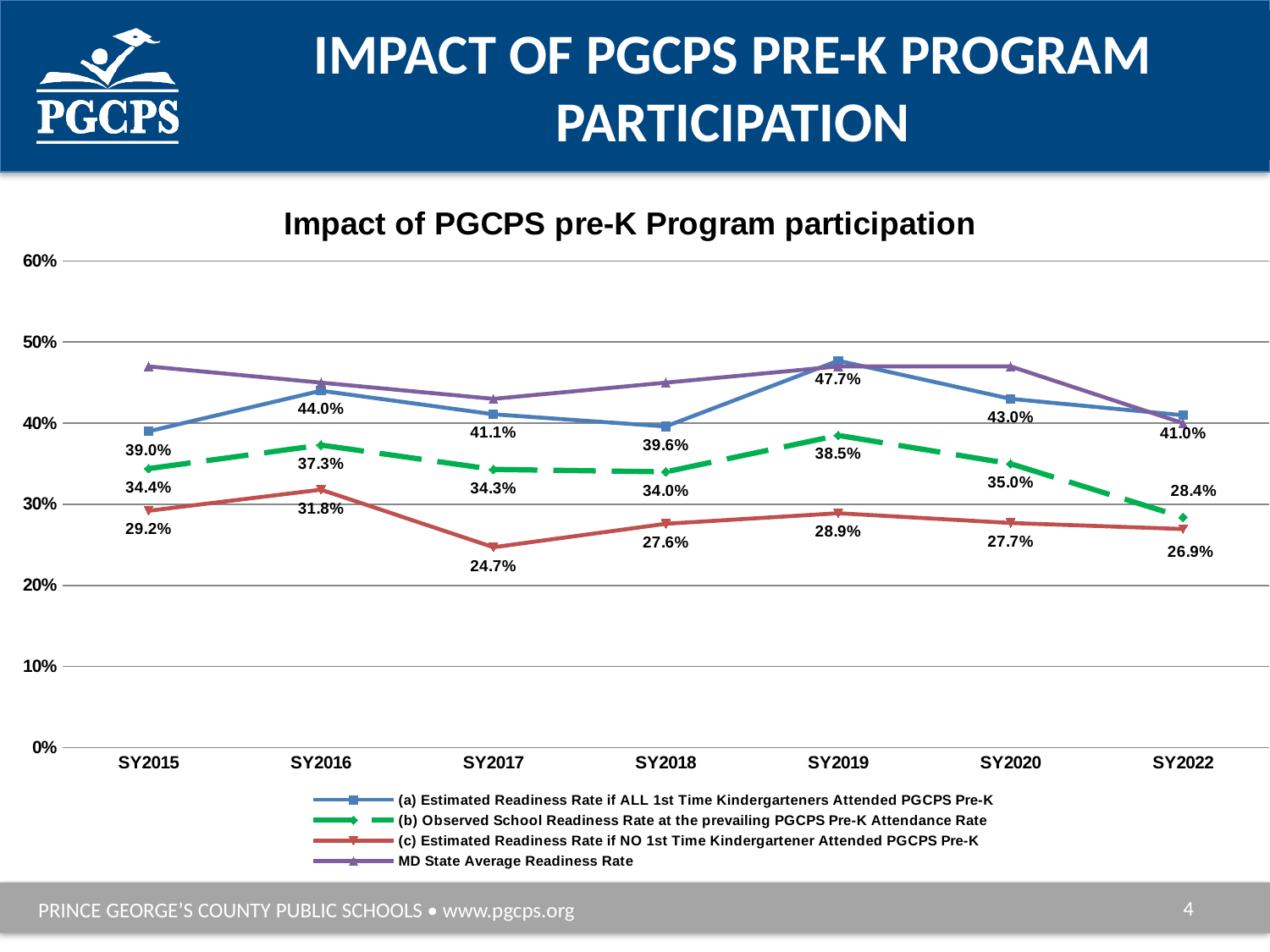
In which school year is the Estimated Readiness Rate if NO 1st Time Kindergartener Attended PGCPS Pre-K lowest? SY2017 What is the difference between the Estimated Readiness Rate if ALL attended and the Estimated Readiness Rate if NO one attended for SY2016? 12.2% What is the Estimated Readiness Rate if ALL 1st Time Kindergarteners Attended PGCPS Pre-K for SY2019? 47.7% What is the Estimated Readiness Rate if NO 1st Time Kindergartener Attended PGCPS Pre-K for SY2017? 24.7% What is the title of the chart? Impact of PGCPS pre-K Program participation What is the Observed School Readiness Rate at the prevailing PGCPS Pre-K Attendance Rate for SY2022? 28.4% How many series does the legend list? 4 What type of chart is shown on the slide? line chart Is the MD State Average Readiness Rate for SY2015 greater or less than 40%? greater In which school year is the Estimated Readiness Rate if ALL 1st Time Kindergarteners Attended PGCPS Pre-K highest? SY2019 Which is larger for SY2020: the Observed School Readiness Rate or the Estimated Readiness Rate if NO 1st Time Kindergartener Attended PGCPS Pre-K? Observed School Readiness Rate How many school years are shown on the x axis? 7